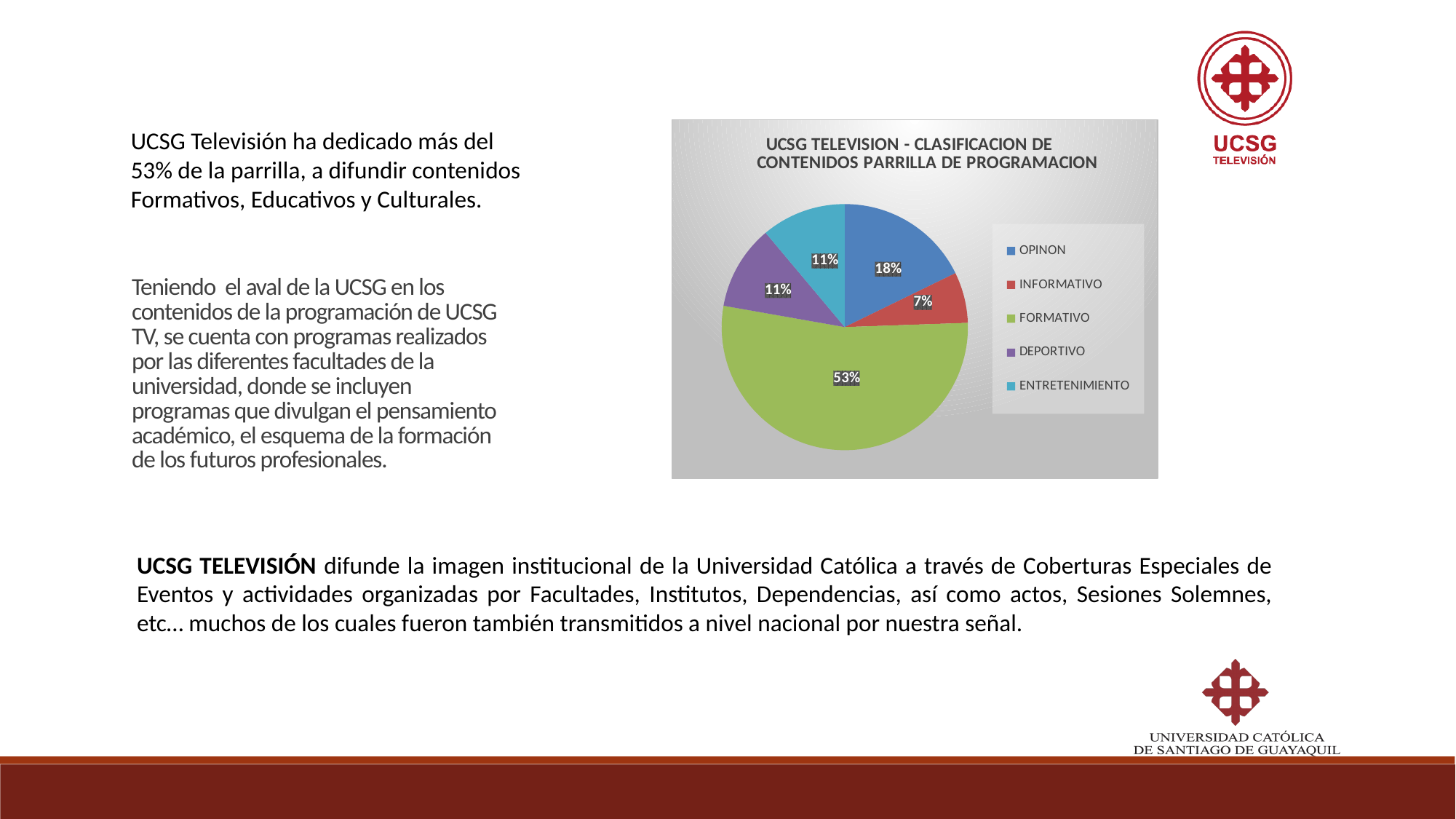
What share of the pie does OPINON have? 18% What is the title of the chart? UCSG TELEVISION - CLASIFICACION DE CONTENIDOS PARRILLA DE PROGRAMACION What share of the pie does INFORMATIVO have? 7% What share of the pie does FORMATIVO have? 53% Which category has the largest slice of the pie? FORMATIVO What is the difference between the FORMATIVO share and the OPINON share? 35% Which category has the smallest slice of the pie? INFORMATIVO What colour is the FORMATIVO slice in the pie chart? green How many categories does the pie chart show? 5 Which is larger, the OPINON slice or the ENTRETENIMIENTO slice? OPINON What kind of chart is shown on the slide? pie chart